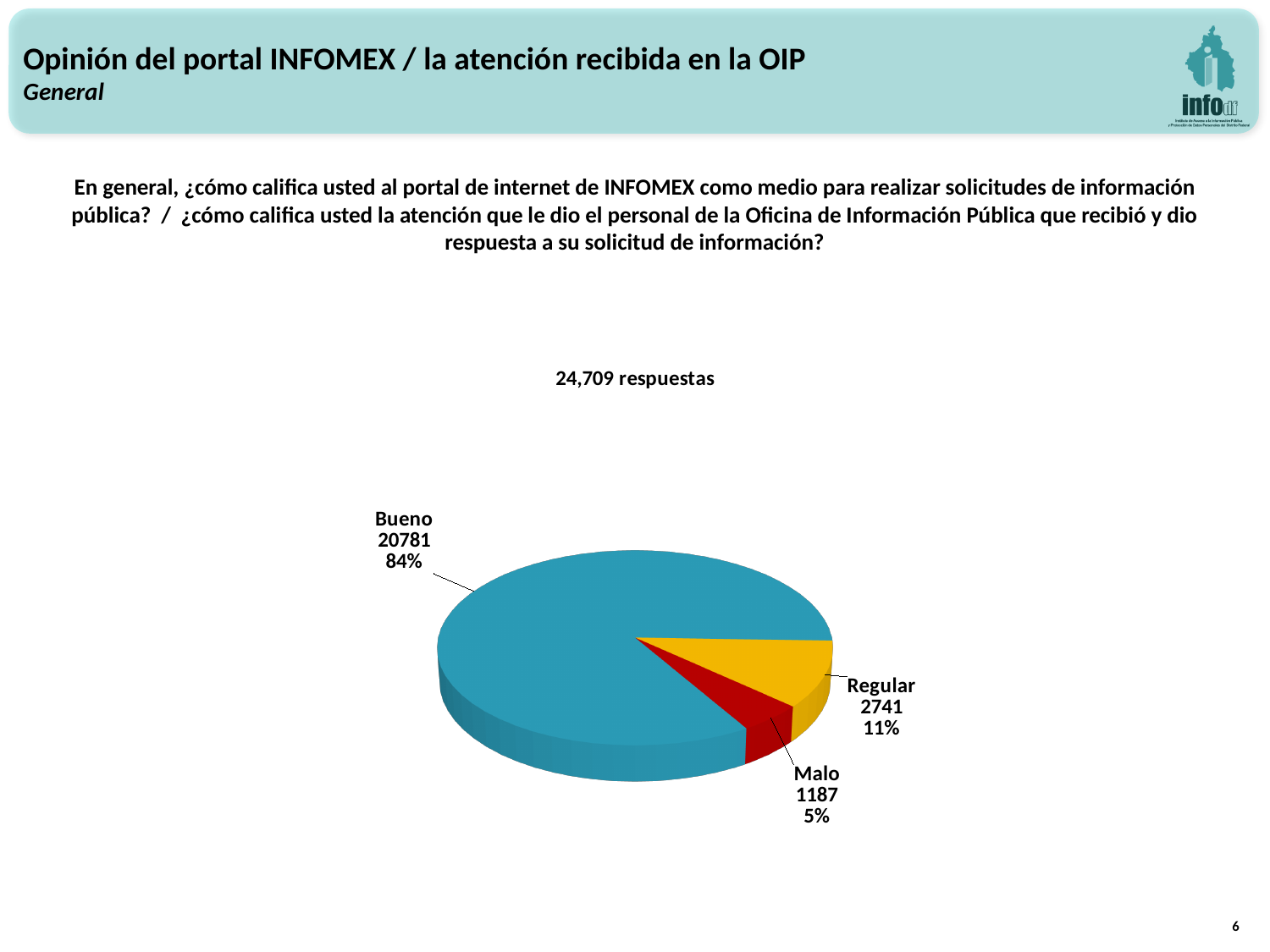
What is the total number of responses stated above the chart? 24,709 respuestas Which category has the smallest slice? Malo What share of the pie does Malo represent? 5% What is the value for Bueno? 20781 What is the value for Regular? 2741 What is the value for Malo? 1187 Which category has the largest slice? Bueno What is the difference between the values for Regular and Malo? 1554 How many slices does the pie chart have? 3 Which is larger, the value for Regular or the value for Malo? Regular What share of the pie does Bueno represent? 84% What kind of chart is shown on the slide? pie chart